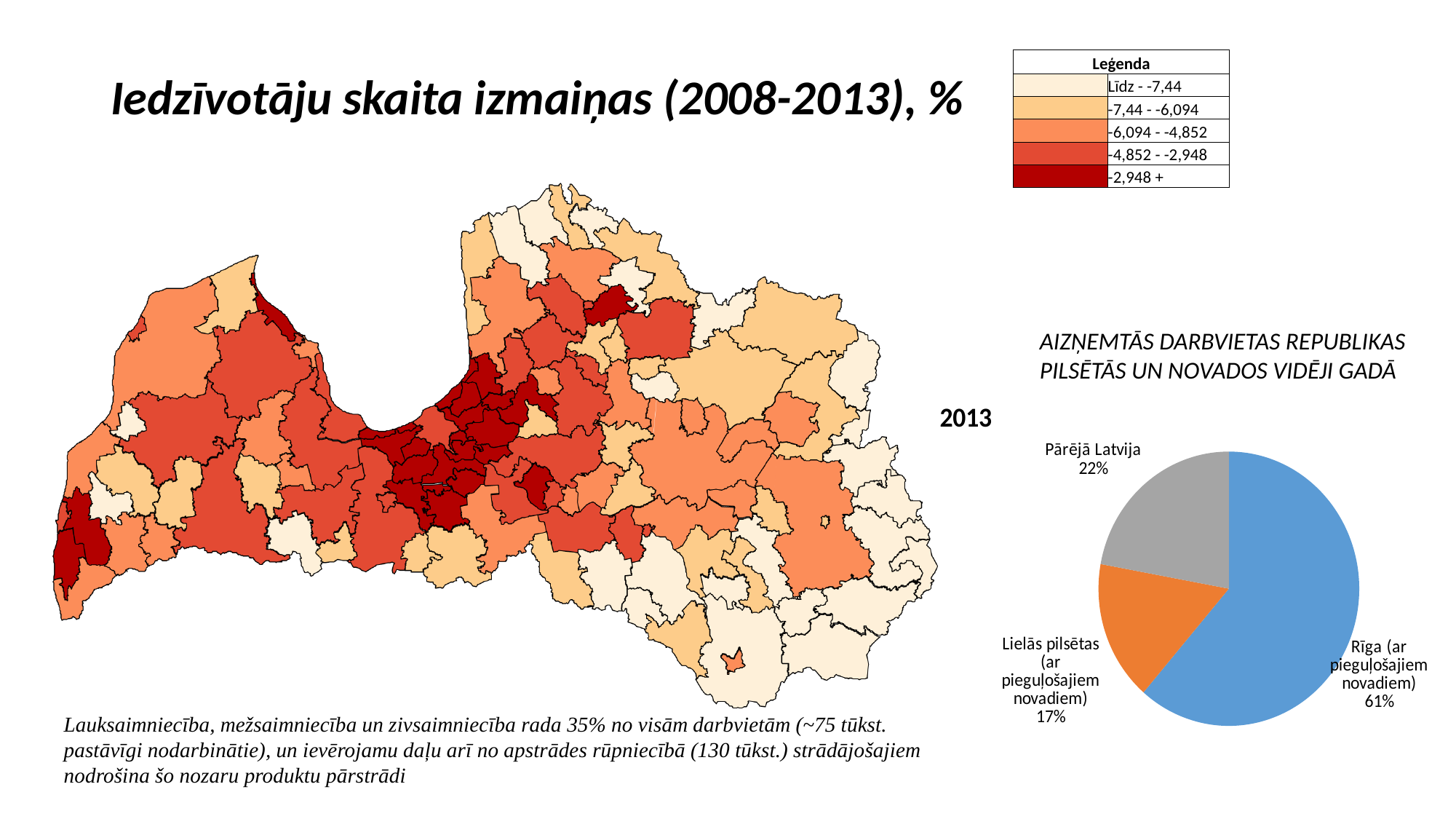
What colour is the Rīga (ar pieguļošajiem novadiem) slice in the pie chart? blue In the pie chart, what share is shown for Rīga (ar pieguļošajiem novadiem)? 61% In the pie chart, what share is shown for Pārējā Latvija? 22% In the pie chart, what share is shown for Lielās pilsētas (ar pieguļošajiem novadiem)? 17% In the pie chart, which is larger: the share for Pārējā Latvija or the share for Lielās pilsētas (ar pieguļošajiem novadiem)? Pārējā Latvija What kind of chart is shown on the right side of the slide under the title 'AIZŅEMTĀS DARBVIETAS REPUBLIKAS PILSĒTĀS UN NOVADOS VIDĒJI GADĀ'? pie chart In the pie chart, what is the difference in percentage points between Rīga (ar pieguļošajiem novadiem) and Pārējā Latvija? 39 In the pie chart, which category has the largest share? Rīga (ar pieguļošajiem novadiem) In the pie chart, which category has the smallest share? Lielās pilsētas (ar pieguļošajiem novadiem) How many value ranges does the map legend ('Leģenda') list? 5 Which year is labelled next to the pie chart? 2013 In the pie chart, how many slices are there? 3